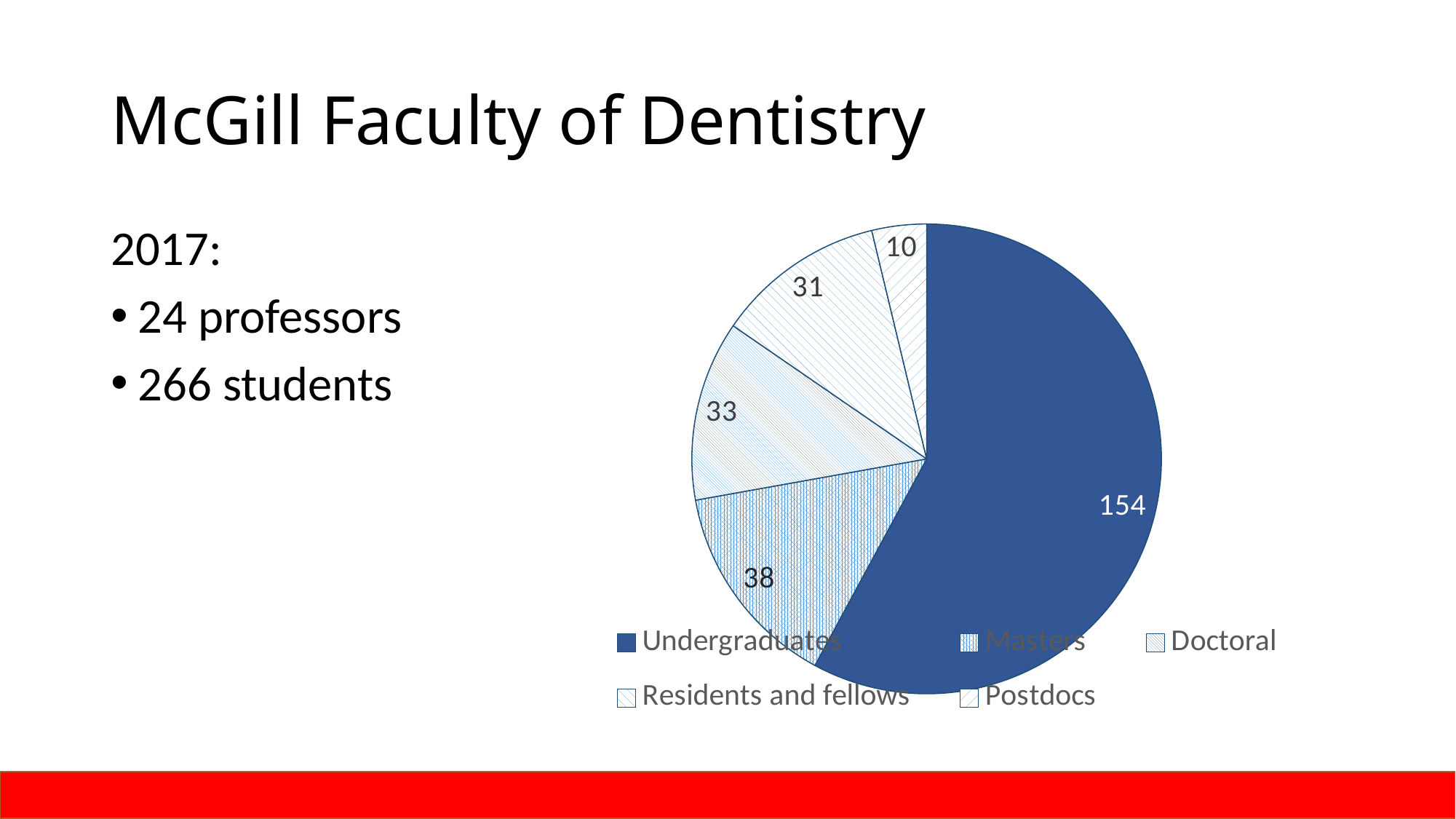
Which category has the largest slice of the pie chart? Undergraduates What is the total of all the values shown in the pie chart? 266 How many students are Undergraduates according to the pie chart? 154 What is the value shown for Doctoral in the pie chart? 33 What is the value shown for Postdocs in the pie chart? 10 How many categories does the legend of the pie chart list? 5 Which is larger, the Masters slice or the Doctoral slice? Masters What is the value shown for Residents and fellows in the pie chart? 31 What type of chart is shown on the slide? pie chart What is the difference between the Undergraduates value and the Masters value? 116 What is the value shown for Masters in the pie chart? 38 Which category has the smallest slice of the pie chart? Postdocs